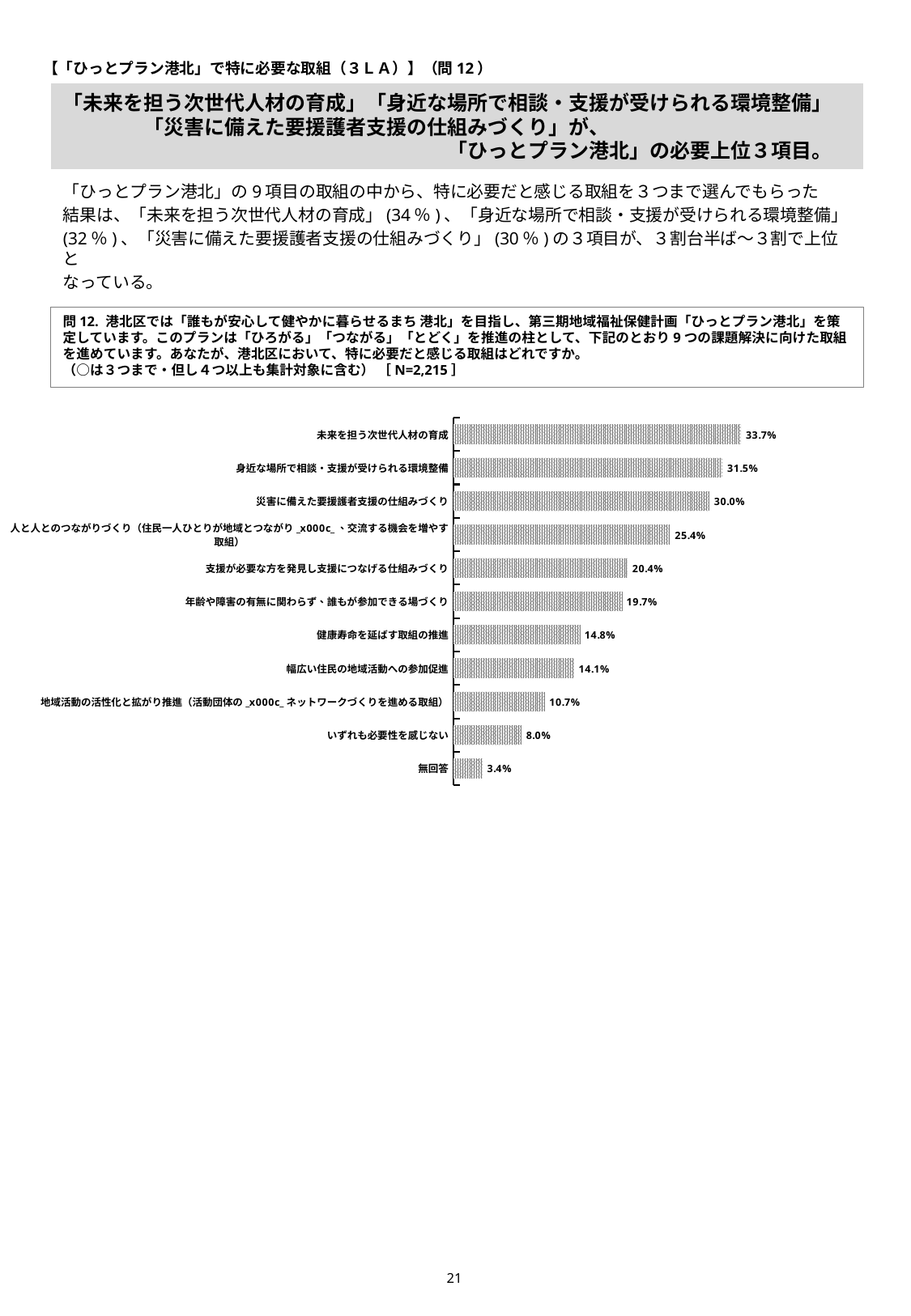
How many categories (bars) does the chart show? 11 Which is larger: the value for 年齢や障害の有無に関わらず、誰もが参加できる場づくり or the value for 健康寿命を延ばす取組の推進? 年齢や障害の有無に関わらず、誰もが参加できる場づくり What is the value for いずれも必要性を感じない? 8.0% What is the sample size (N) stated in the question box above the chart? N=2,215 What is the value for 災害に備えた要援護者支援の仕組みづくり? 30.0% What is the difference between the values for 未来を担う次世代人材の育成 and 身近な場所で相談・支援が受けられる環境整備? 2.2% What is the difference between the values for 支援が必要な方を発見し支援につなげる仕組みづくり and 幅広い住民の地域活動への参加促進? 6.3% What is the value for 未来を担う次世代人材の育成? 33.7% What kind of chart is shown on the slide? bar chart Which category has the highest value? 未来を担う次世代人材の育成 Which category has the lowest value? 無回答 What is the value for 健康寿命を延ばす取組の推進? 14.8%